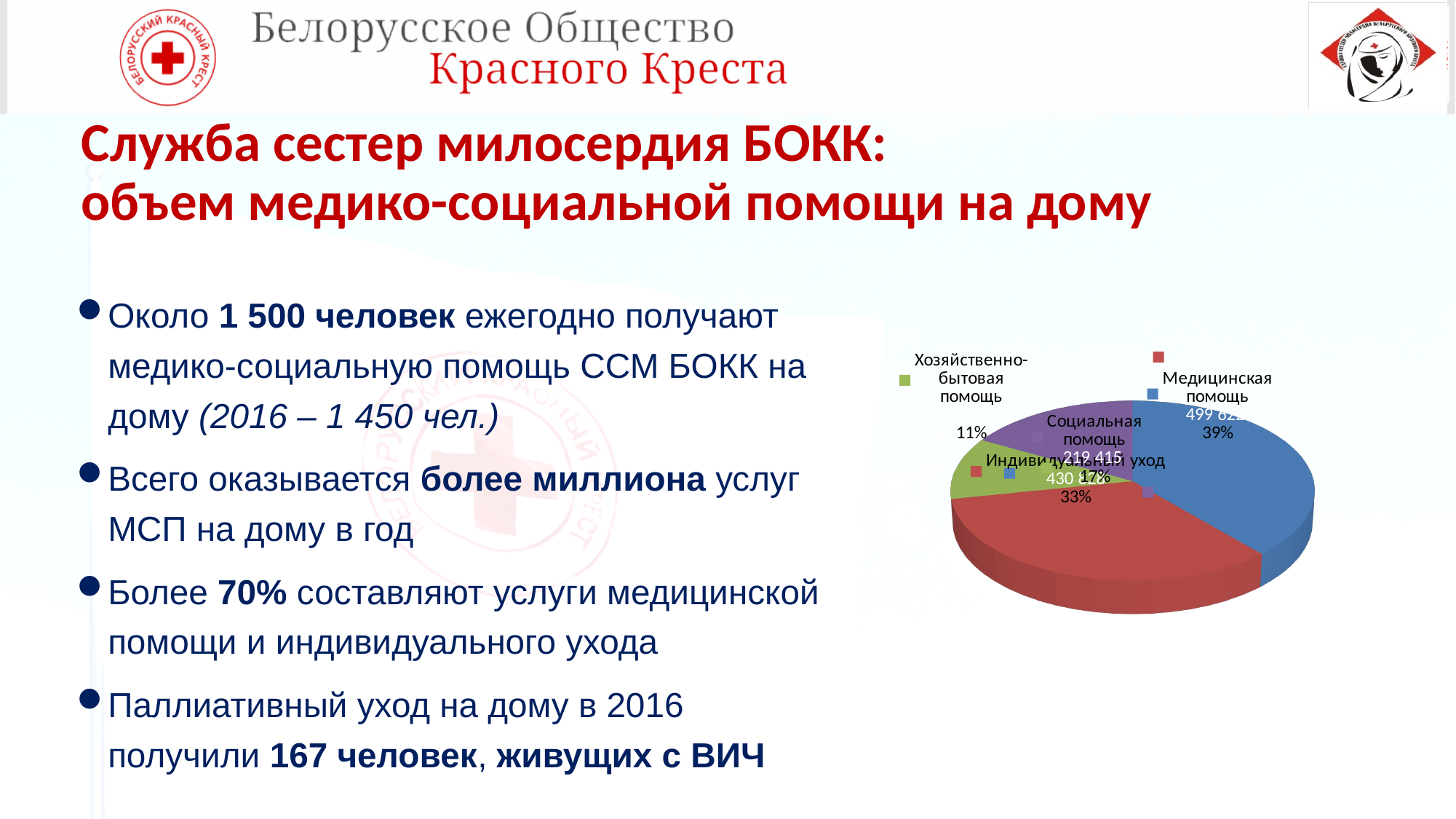
Which is larger: the share for Медицинская помощь or the share for Индивидуальный уход? Медицинская помощь What share of the pie does Хозяйственно-бытовая помощь account for? 11% Which category has the largest slice of the pie? Медицинская помощь What value is printed for Социальная помощь in the pie chart? 219 415 What is the difference in percentage points between the share for Медицинская помощь and the share for Хозяйственно-бытовая помощь? 28 Which category has the smallest slice of the pie? Хозяйственно-бытовая помощь What share of the pie does Социальная помощь account for? 17% What colour is the Медицинская помощь slice in the pie chart? blue How many slices does the pie chart have? 4 What share of the pie does Индивидуальный уход account for? 33% What kind of chart is shown on the slide? pie chart